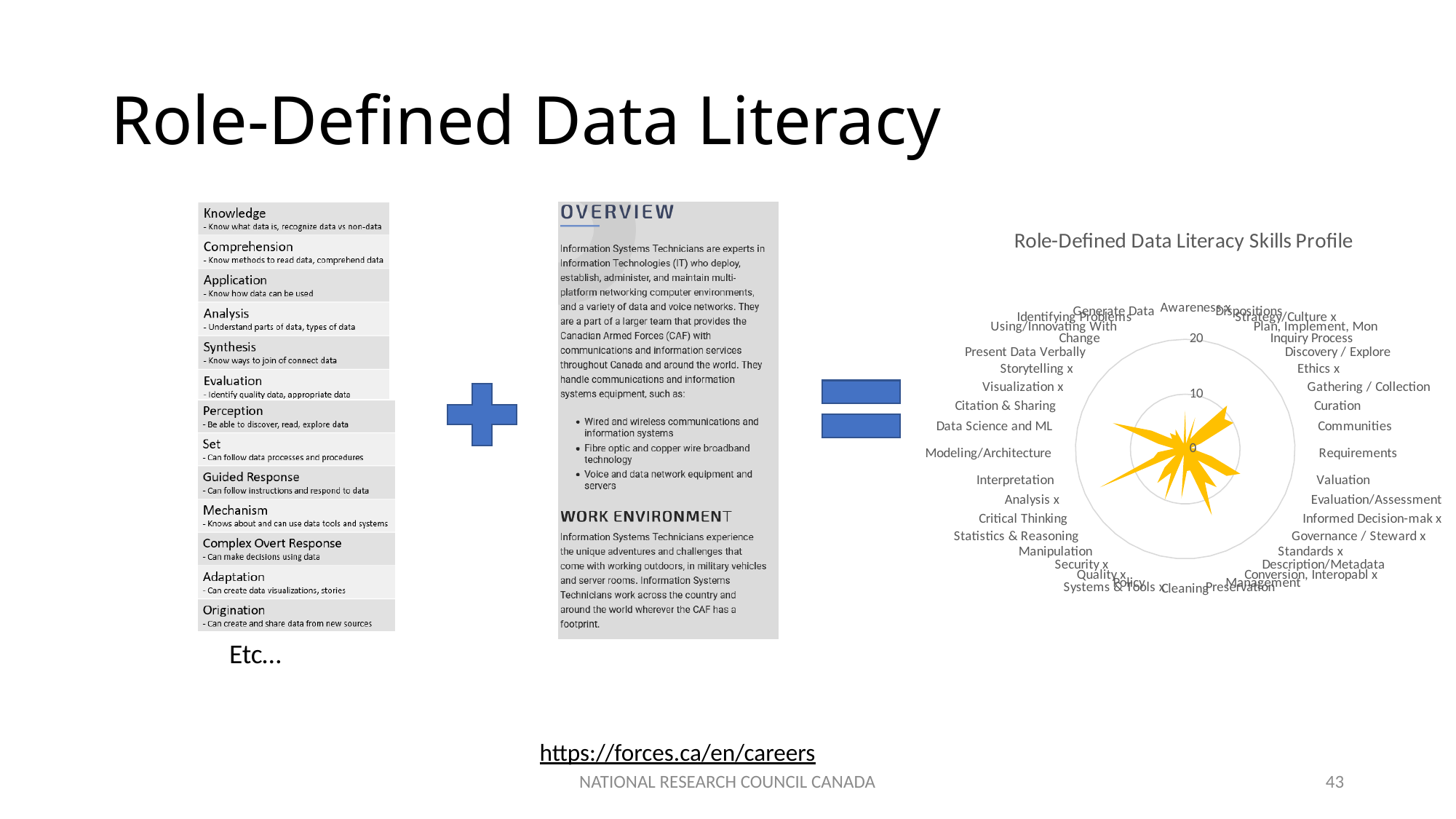
What is the title of the chart on the right side of the slide? Role-Defined Data Literacy Skills Profile In the 'Role-Defined Data Literacy Skills Profile' chart, is the value for Requirements greater or less than 20? less In the 'Role-Defined Data Literacy Skills Profile' chart, is the value for Ethics x greater or less than 20? less In the 'Role-Defined Data Literacy Skills Profile' chart, what is the highest value shown on the radial axis? 20 In the 'Role-Defined Data Literacy Skills Profile' chart, is the value for Valuation greater or less than 10? less What kind of chart is the 'Role-Defined Data Literacy Skills Profile'? Radar chart